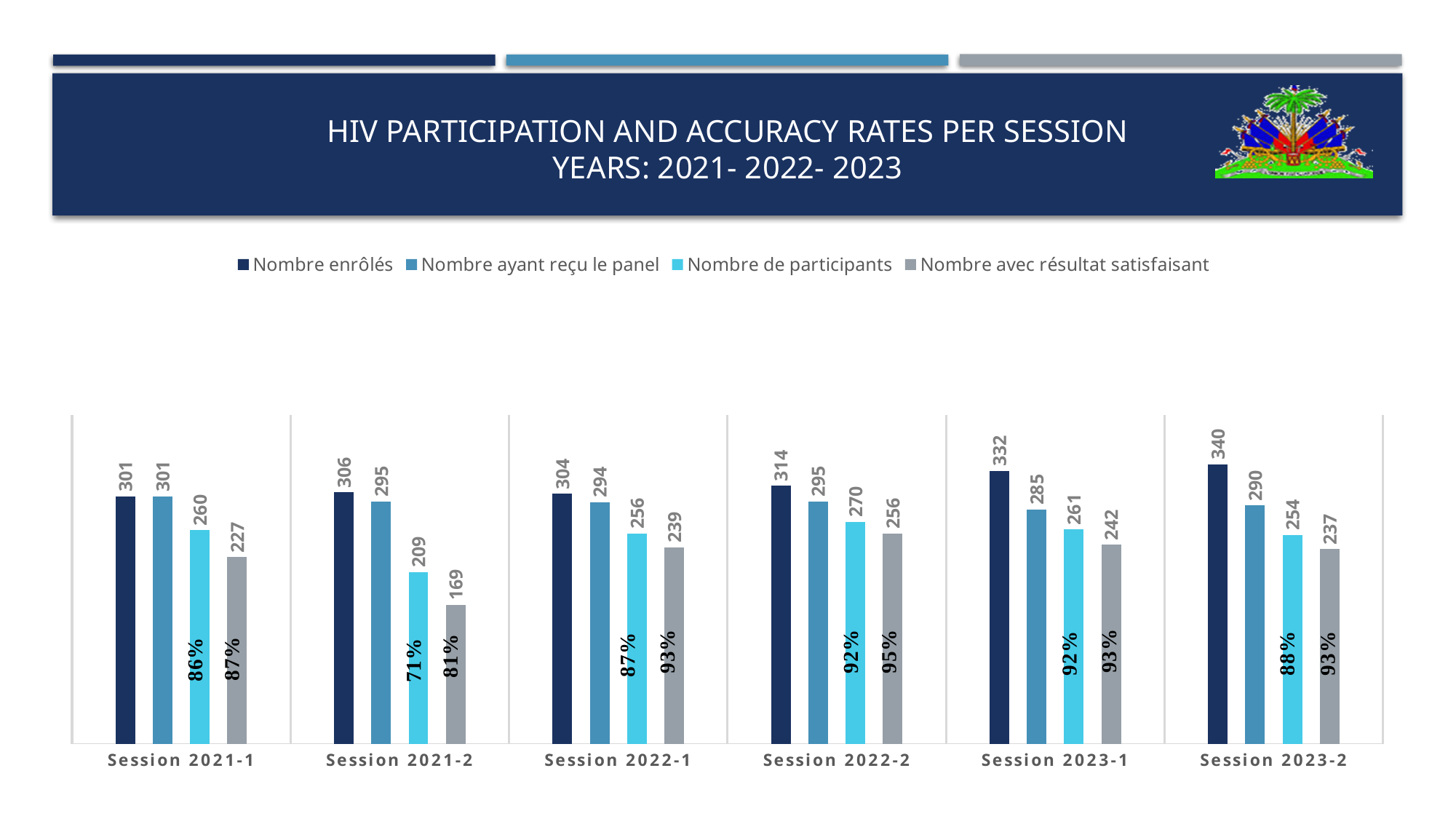
What kind of chart is shown on the slide? Bar chart What is the value of Nombre de participants for Session 2021-2? 209 Which session has the highest value for Nombre enrôlés? Session 2023-2 What is the value of Nombre enrôlés for Session 2023-2? 340 Which is larger for Session 2022-1: Nombre ayant reçu le panel or Nombre de participants? Nombre ayant reçu le panel What colour are the Nombre de participants bars? Light blue (cyan) What is the difference between Nombre enrôlés and Nombre de participants for Session 2023-1? 71 How many series does the legend list? 4 How many sessions are shown on the x axis? 6 What percentage is printed on the Nombre de participants bar for Session 2021-2? 71% What is the value of Nombre avec résultat satisfaisant for Session 2022-2? 256 Which session has the lowest value for Nombre avec résultat satisfaisant? Session 2021-2